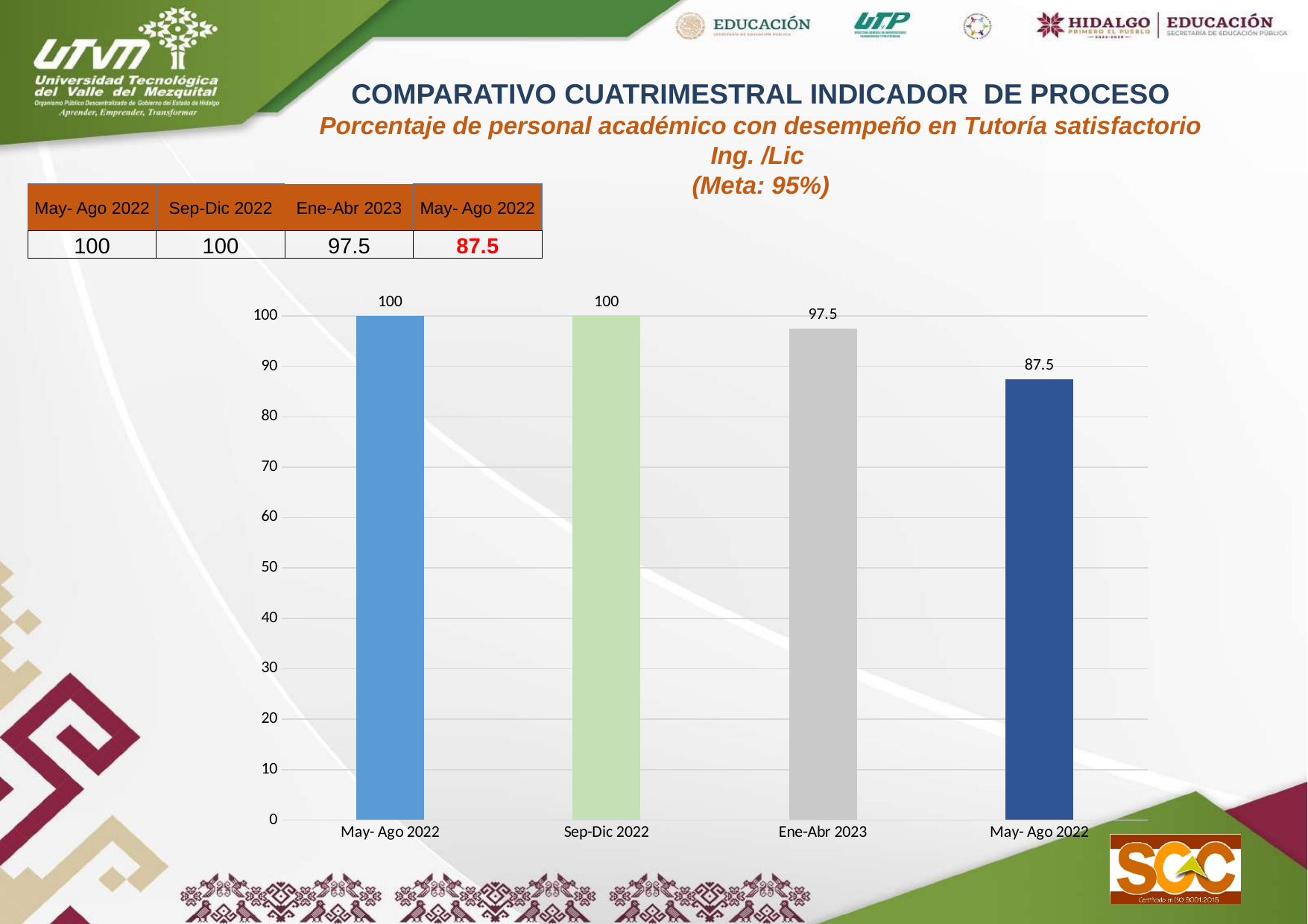
What is the value of the leftmost bar (the first one labelled May- Ago 2022)? 100 Which category has the lowest value? May- Ago 2022 (rightmost bar) What is the difference between the value for Ene-Abr 2023 and the rightmost bar (May- Ago 2022)? 10 What kind of chart is shown on the slide? bar chart Do the values rise or fall from left to right across the chart? fall What is the difference between the value for Sep-Dic 2022 and Ene-Abr 2023? 2.5 What is the value for Sep-Dic 2022? 100 What is the value of the rightmost bar (the second one labelled May- Ago 2022)? 87.5 Is the value of the rightmost bar (May- Ago 2022) greater or less than 90? less Which is larger, the value for Ene-Abr 2023 or the value of the rightmost bar (May- Ago 2022)? Ene-Abr 2023 How many bars are shown in the chart? 4 What is the value for Ene-Abr 2023? 97.5